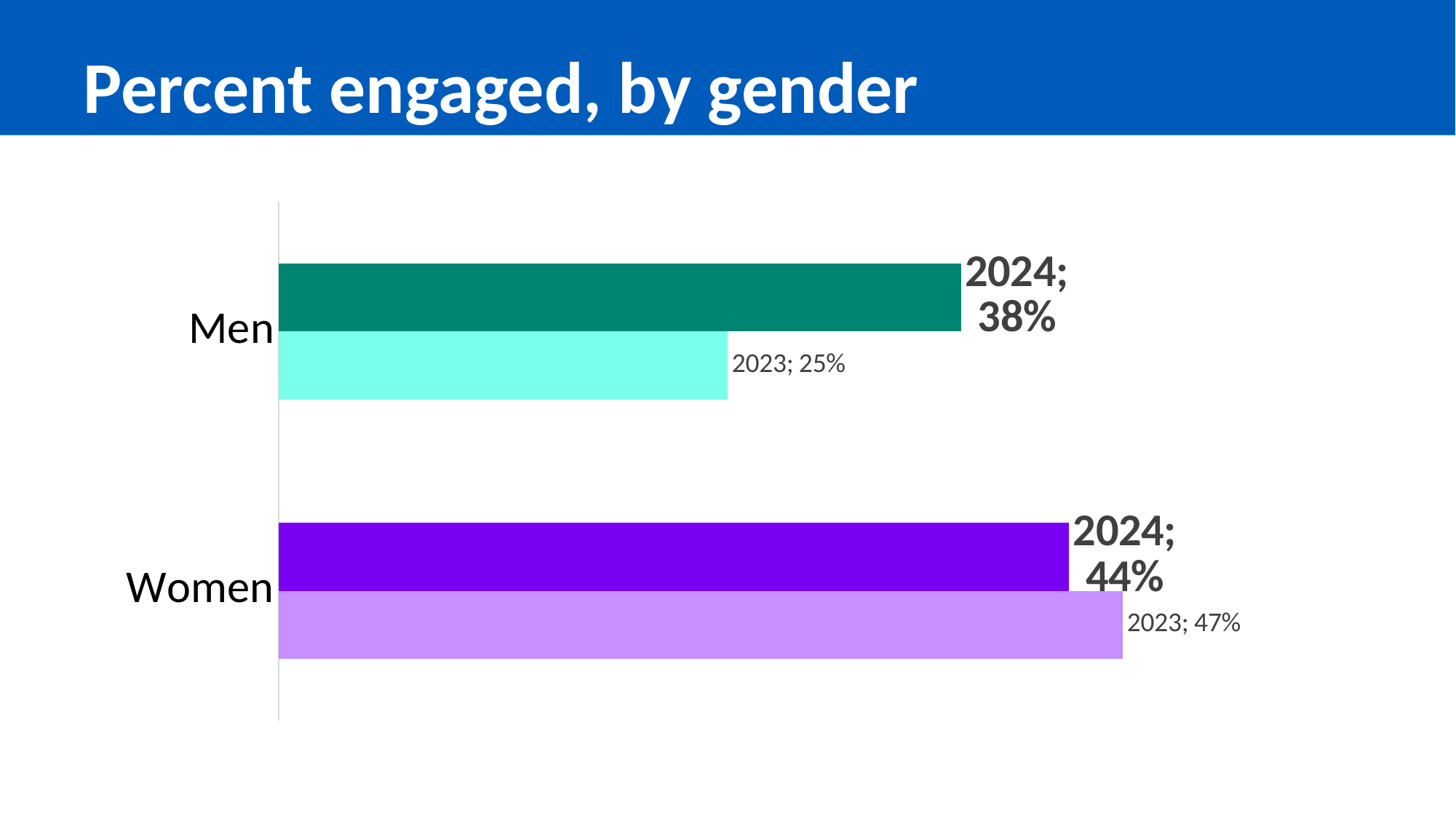
What is the difference between the 2024 and 2023 values for Men? 13 percentage points What is the value for Women in 2023? 47% What is the value for Women in 2024? 44% Is the 2024 value for Women larger or smaller than the 2023 value for Women? smaller Which gender has the higher percent engaged in 2024? Women What kind of chart is shown on the slide? bar chart What is the difference between the 2023 and 2024 values for Women? 3 percentage points How many gender categories are shown on the chart? 2 What is the value for Men in 2024? 38% Which bar shows the lowest value on the chart? Men, 2023 (25%) What is the value for Men in 2023? 25% What is the title of the slide? Percent engaged, by gender